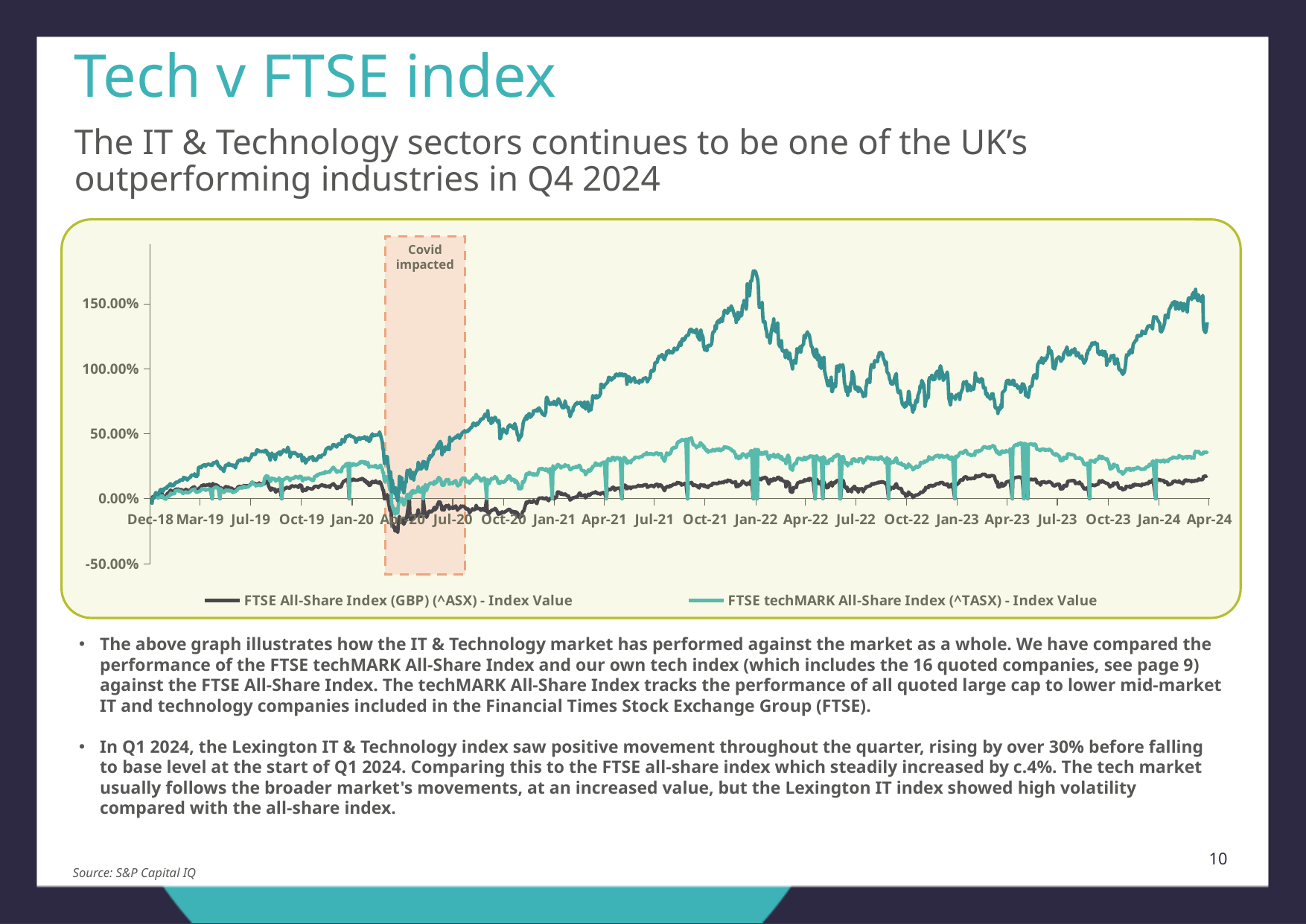
What is the highest value labelled on the y axis of the chart? 150.00% Overall, does the FTSE All-Share Index (GBP) (^ASX) line rise or fall from Dec-18 to Apr-24? Rise Is the lowest point of the FTSE All-Share Index (GBP) (^ASX) line, around Apr-20, greater or less than 0.00%? less Is the value of the FTSE All-Share Index (GBP) (^ASX) at Apr-24 greater or less than 50.00%? less What label is given to the shaded region on the chart around Apr-20? Covid impacted At Apr-24, which series is higher: the FTSE All-Share Index (GBP) (^ASX) or the FTSE techMARK All-Share Index (^TASX)? FTSE techMARK All-Share Index (^TASX) What is the lowest value labelled on the y axis of the chart? -50.00% What is the last date label on the x axis of the chart? Apr-24 What kind of chart is shown on the slide? Line chart What is the first date label on the x axis of the chart? Dec-18 How many series does the chart's legend list? 2 Is the value of the FTSE techMARK All-Share Index (^TASX) at Apr-24 greater or less than 50.00%? less